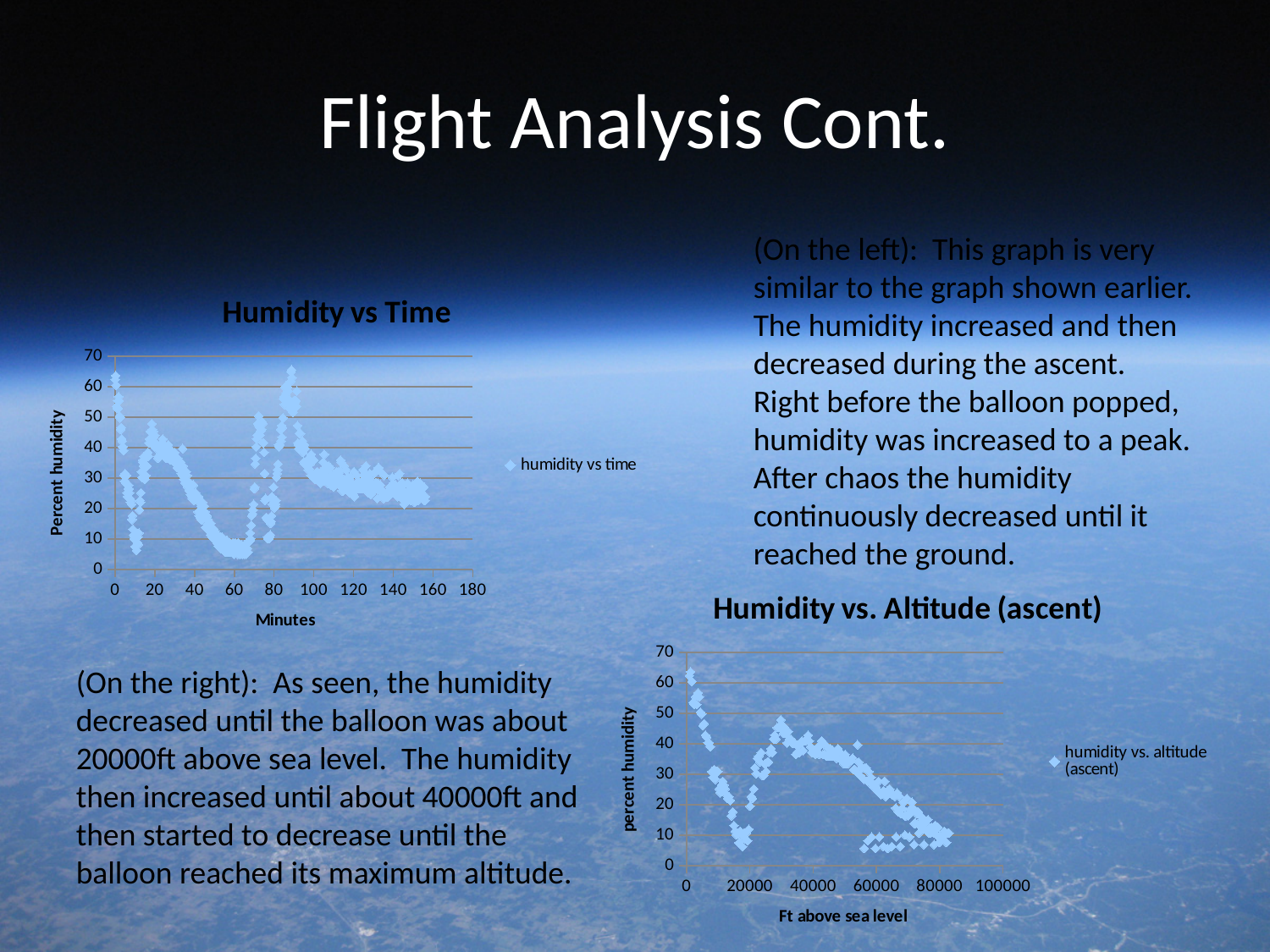
In the 'Humidity vs. Altitude (ascent)' chart, is the humidity at around 40000 ft greater or less than 30? greater How many series does the legend of the 'Humidity vs Time' chart list? 1 What type of chart is the 'Humidity vs Time' chart? scatter chart In the 'Humidity vs. Altitude (ascent)' chart, what is the label of the x axis? Ft above sea level In the 'Humidity vs Time' chart, is the peak humidity at around 90 minutes greater or less than 50? greater What type of chart is the 'Humidity vs. Altitude (ascent)' chart? scatter chart In the 'Humidity vs Time' chart, what is the label of the x axis? Minutes In the 'Humidity vs Time' chart, is the humidity at around 60 minutes greater or less than 10? less In the 'Humidity vs. Altitude (ascent)' chart, does the humidity overall rise or fall from the lowest altitude to the highest altitude plotted? fall How many series does the legend of the 'Humidity vs. Altitude (ascent)' chart list? 1